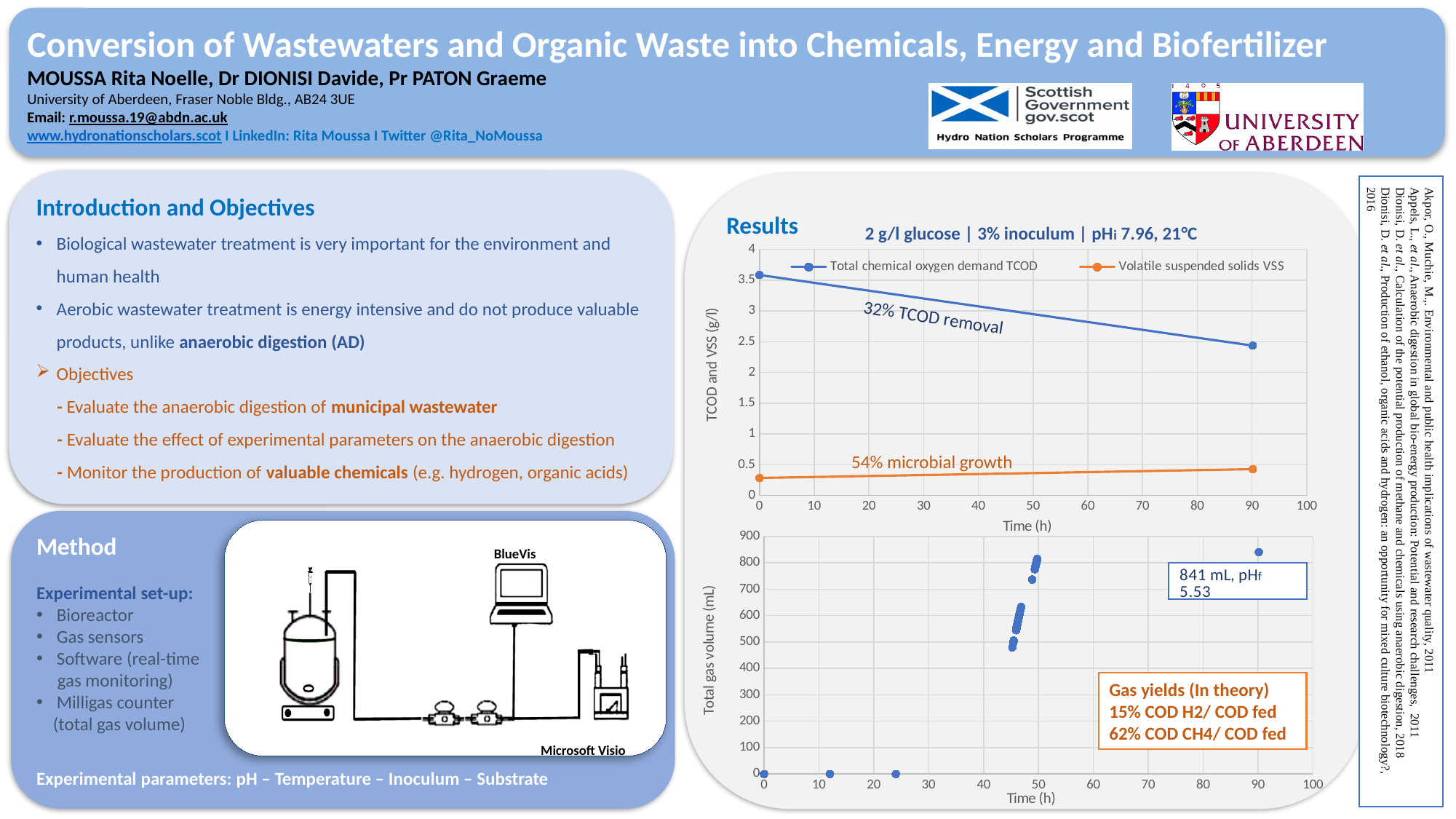
In the bottom chart, is the total gas volume at 24 h greater or less than 100? less In the top chart, is the TCOD value at 0 h greater or less than 3? greater In the top chart, is the VSS value at 90 h greater or less than 0.5? less In the top chart, does the Total chemical oxygen demand TCOD series rise or fall along the x axis? fall In the top chart, does the Volatile suspended solids VSS series rise or fall along the x axis? rise In the bottom chart, what total gas volume is labelled for the final point at about 90 h? 841 mL In the top chart, which series has the higher value at 90 h, TCOD or VSS? Total chemical oxygen demand TCOD What kind of chart is the top chart (TCOD and VSS against time)? line chart How many series does the legend of the top chart list? 2 What kind of chart is the bottom chart (Total gas volume against time)? scatter chart What percentage TCOD removal is annotated on the top chart? 32%